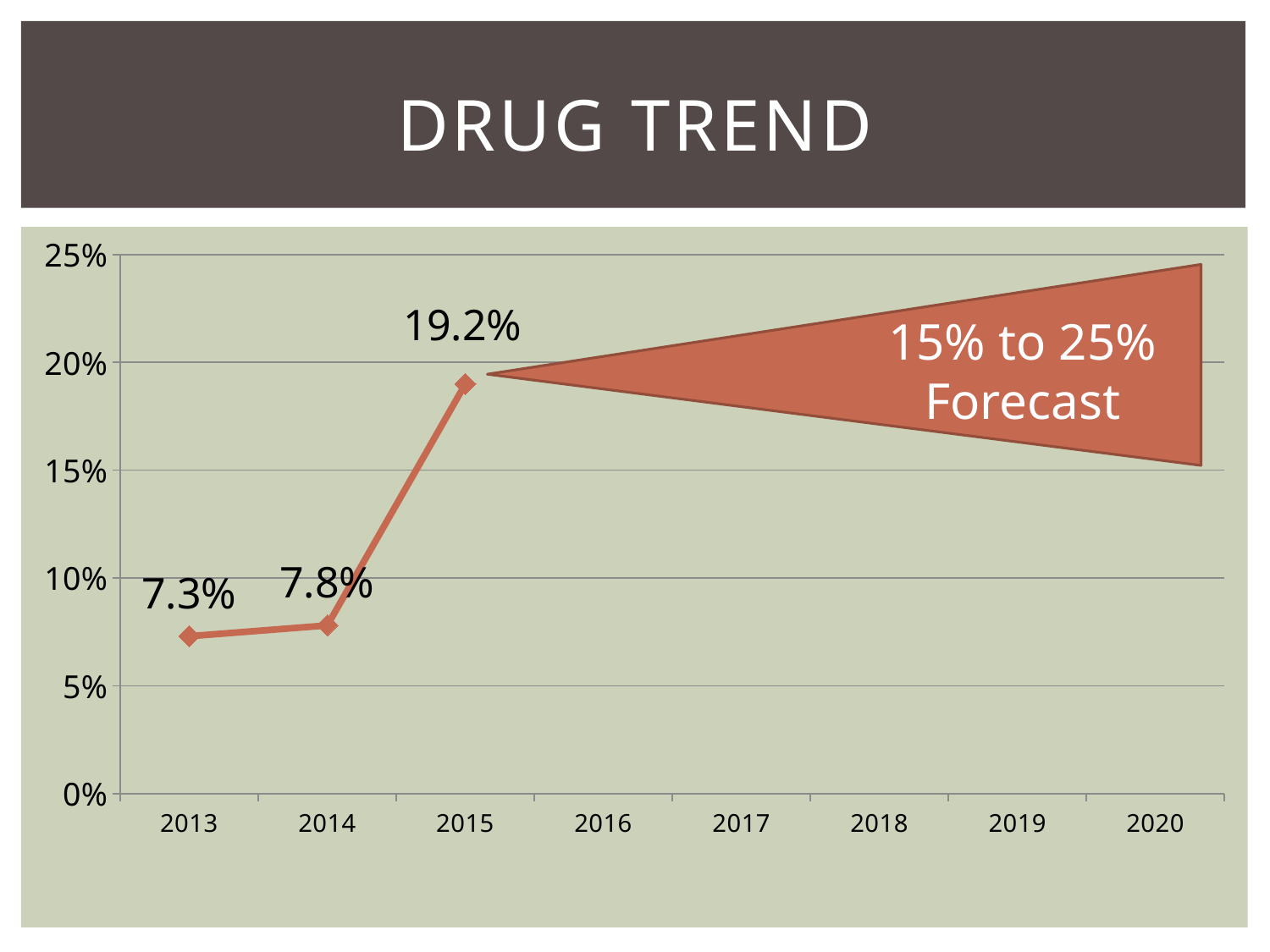
What is the value for 2015? 19.2% Do the plotted values rise or fall from 2013 to 2015? rise What is the difference between the values for 2015 and 2014? 11.4% What is the difference between the values for 2014 and 2013? 0.5% What forecast range is shown in the shaded wedge for the years after 2015? 15% to 25% What is the value for 2014? 7.8% What is the value for 2013? 7.3% Which year has the lowest plotted value? 2013 Which year has the highest plotted value? 2015 Is the value for 2015 greater or less than 15%? greater Which is larger, the value for 2014 or the value for 2015? 2015 What kind of chart is shown on the slide? line chart